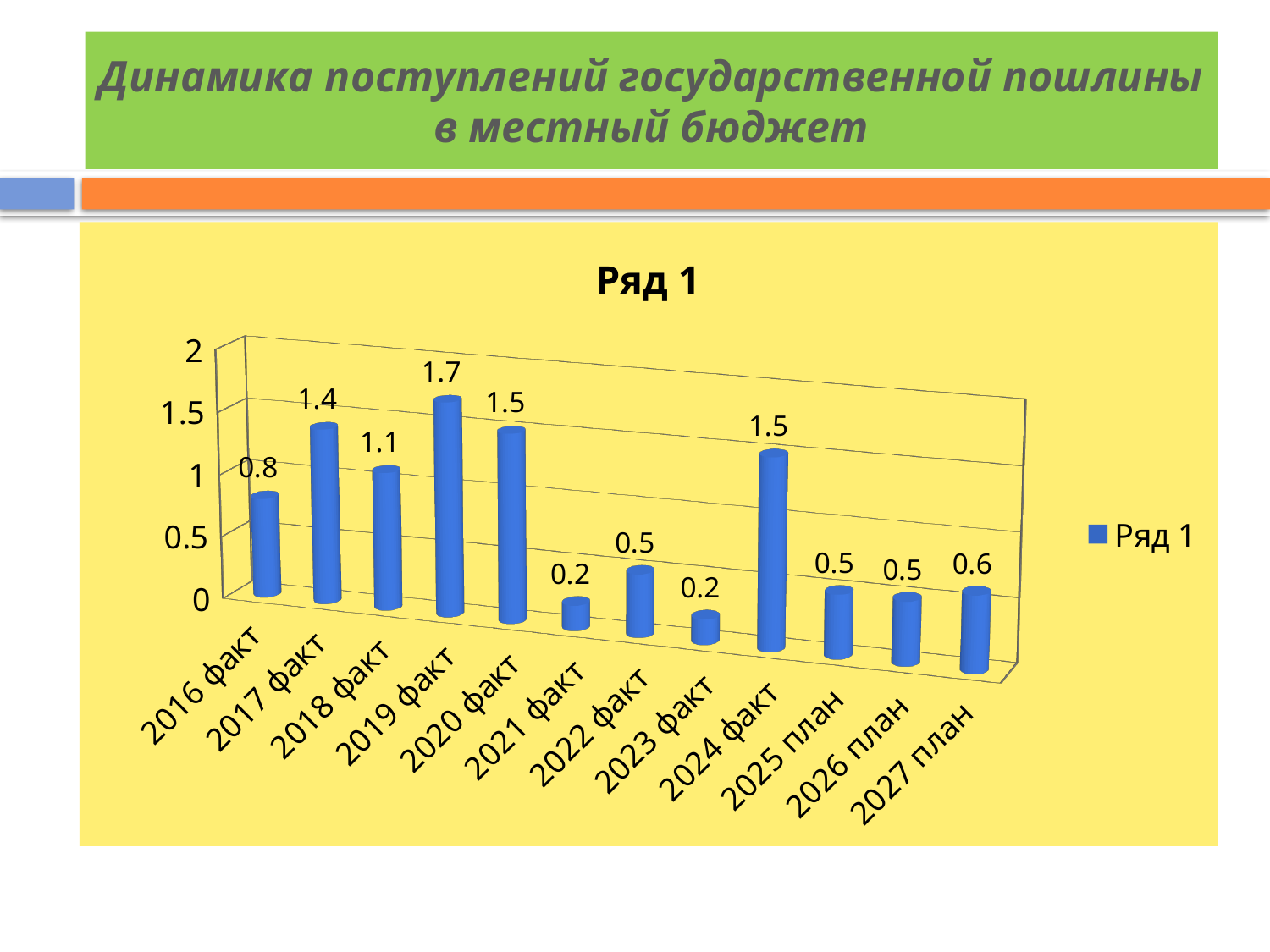
Which is larger, the value for 2016 факт or the value for 2022 факт? 2016 факт What kind of chart is shown? bar chart What is the difference between the values for 2019 факт and 2018 факт? 0.6 What is the title of the chart? Ряд 1 What is the value for 2027 план? 0.6 How many categories are shown on the x axis? 12 What is the difference between the values for 2024 факт and 2025 план? 1 Which is larger, the value for 2017 факт or the value for 2020 факт? 2020 факт What is the value for 2019 факт? 1.7 How many series does the legend list? 1 What is the value for 2024 факт? 1.5 Which category has the highest value? 2019 факт